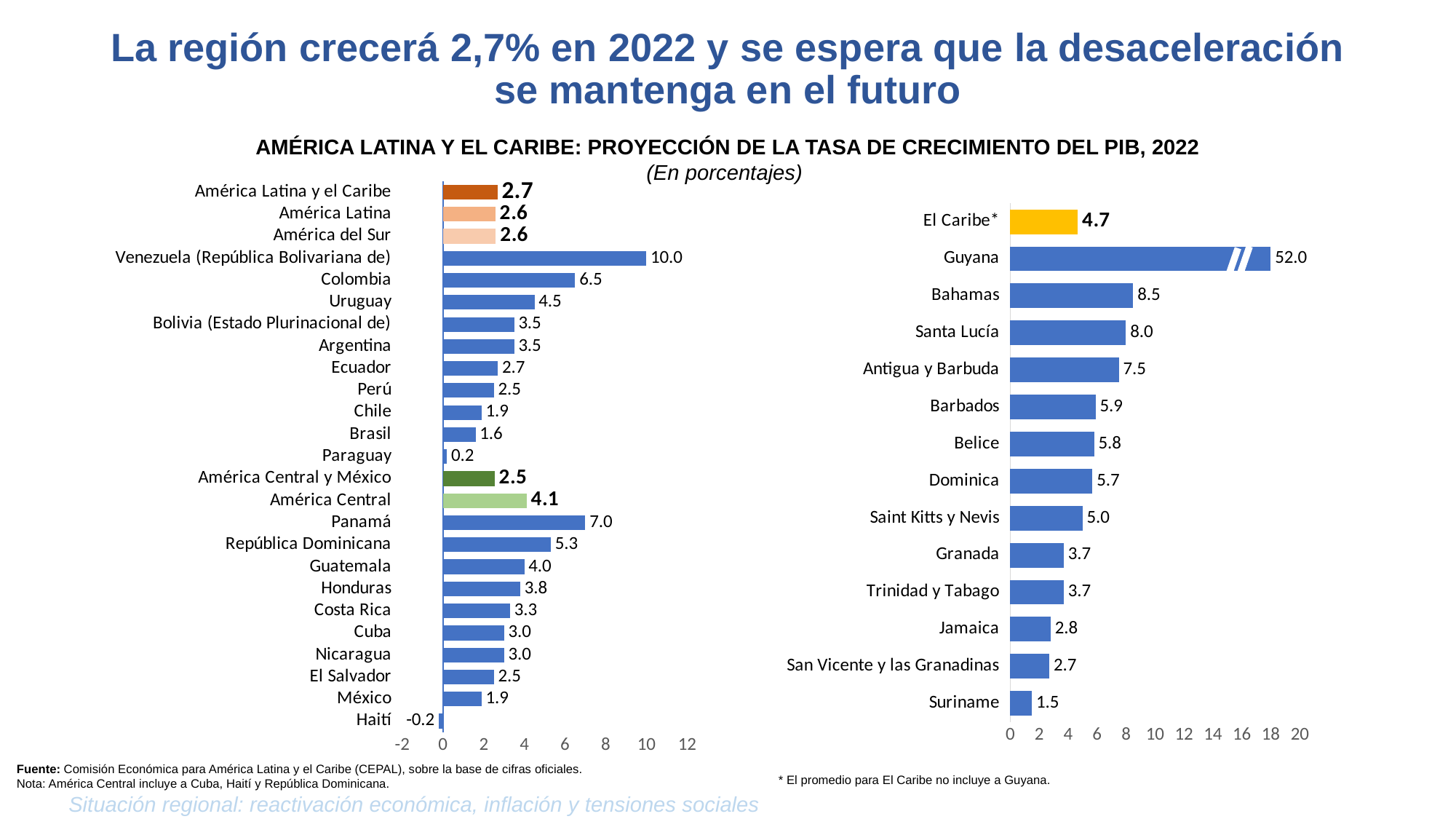
In the left chart, what is the difference between the values for Panamá and Guatemala? 3.0 In the left chart, what colour is the bar for América Latina y el Caribe? Orange What type of chart is used on this slide? Bar chart How many bars are shown in the right chart? 14 In the right chart, which country has the highest value? Guyana In the left chart, which country has the lowest projected growth rate? Haití In the right chart, which is larger, the value for Bahamas or the value for Santa Lucía? Bahamas In the left chart, what is the projected GDP growth rate for Venezuela (República Bolivariana de)? 10.0 In the left chart, what is the value shown for Haití? -0.2 In the right chart, what is the value for El Caribe*? 4.7 In the right chart, what is the value shown for Guyana? 52.0 In the right chart, which country has the lowest value? Suriname